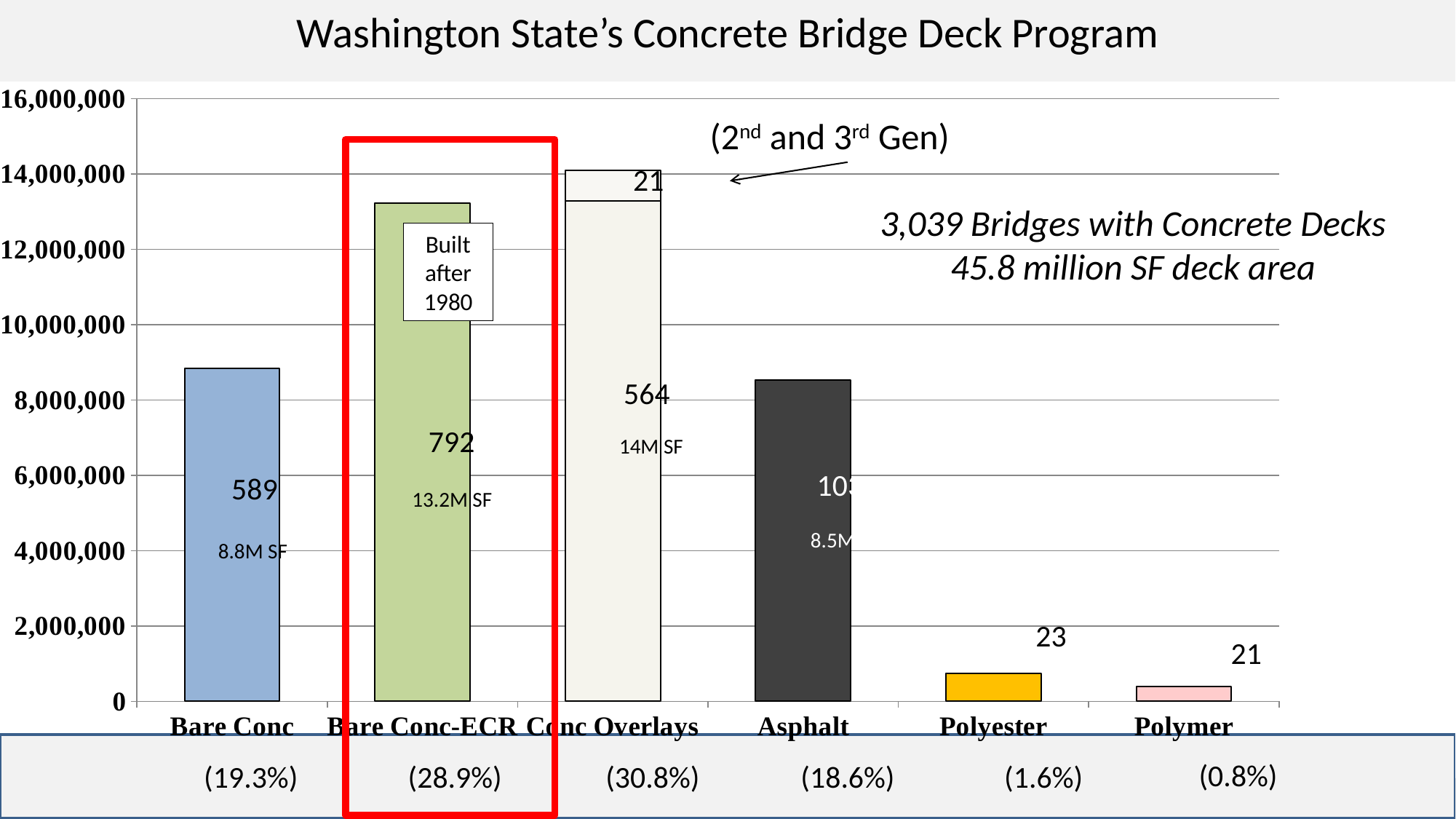
Which has the larger percentage shown below its bar, Bare Conc or Asphalt? Bare Conc What percentage is shown below the Asphalt bar? 18.6% What number is printed on the Bare Conc bar? 589 What type of chart is shown on the slide? bar chart Is the value for Asphalt greater or less than 8,000,000? greater What text is in the box placed on the Bare Conc-ECR bar? Built after 1980 What is the difference between the numbers printed on the Bare Conc-ECR bar and the Bare Conc bar? 203 Which deck category has the tallest bar? Conc Overlays What number is printed on the Bare Conc-ECR bar? 792 How many deck categories are shown along the x axis? 6 Which deck category has the shortest bar? Polymer What deck area is printed on the Bare Conc-ECR bar? 13.2M SF